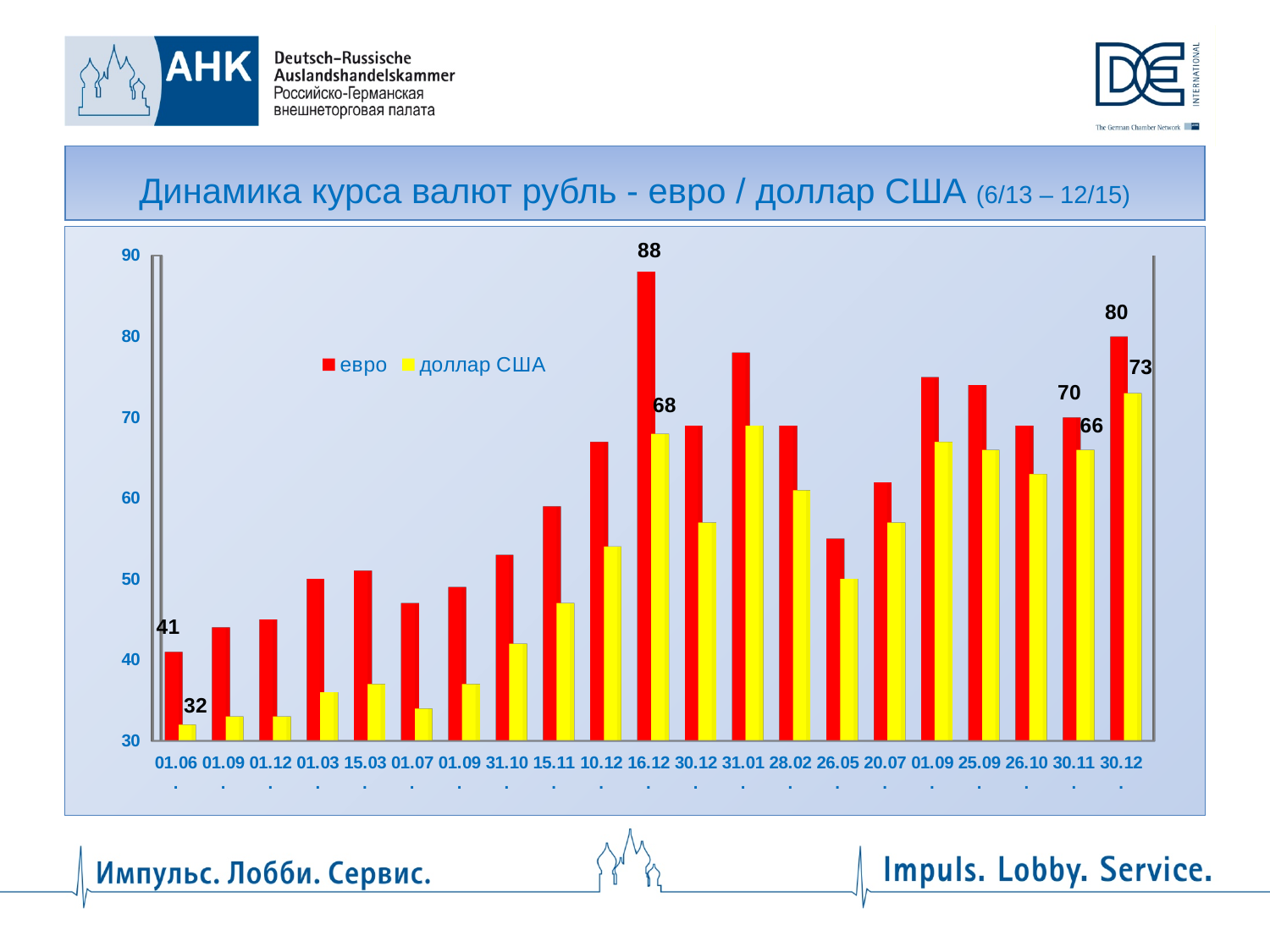
What is the difference between the евро and доллар США values at 16.12? 20 What is the value of the евро series at the rightmost category, 30.12? 80 At which category does the евро series reach its highest value? 16.12 What is the value of the евро series at the first category, 01.06? 41 What kind of chart is shown on the slide? bar chart What is the value of the евро series at 16.12? 88 What is the value of the евро series at 30.11? 70 How many categories are shown on the x axis? 21 Is the value for евро at 31.01 greater or less than 70? greater What is the value of the доллар США series at the first category, 01.06? 32 What is the value of the доллар США series at 16.12? 68 How many series does the legend list? 2